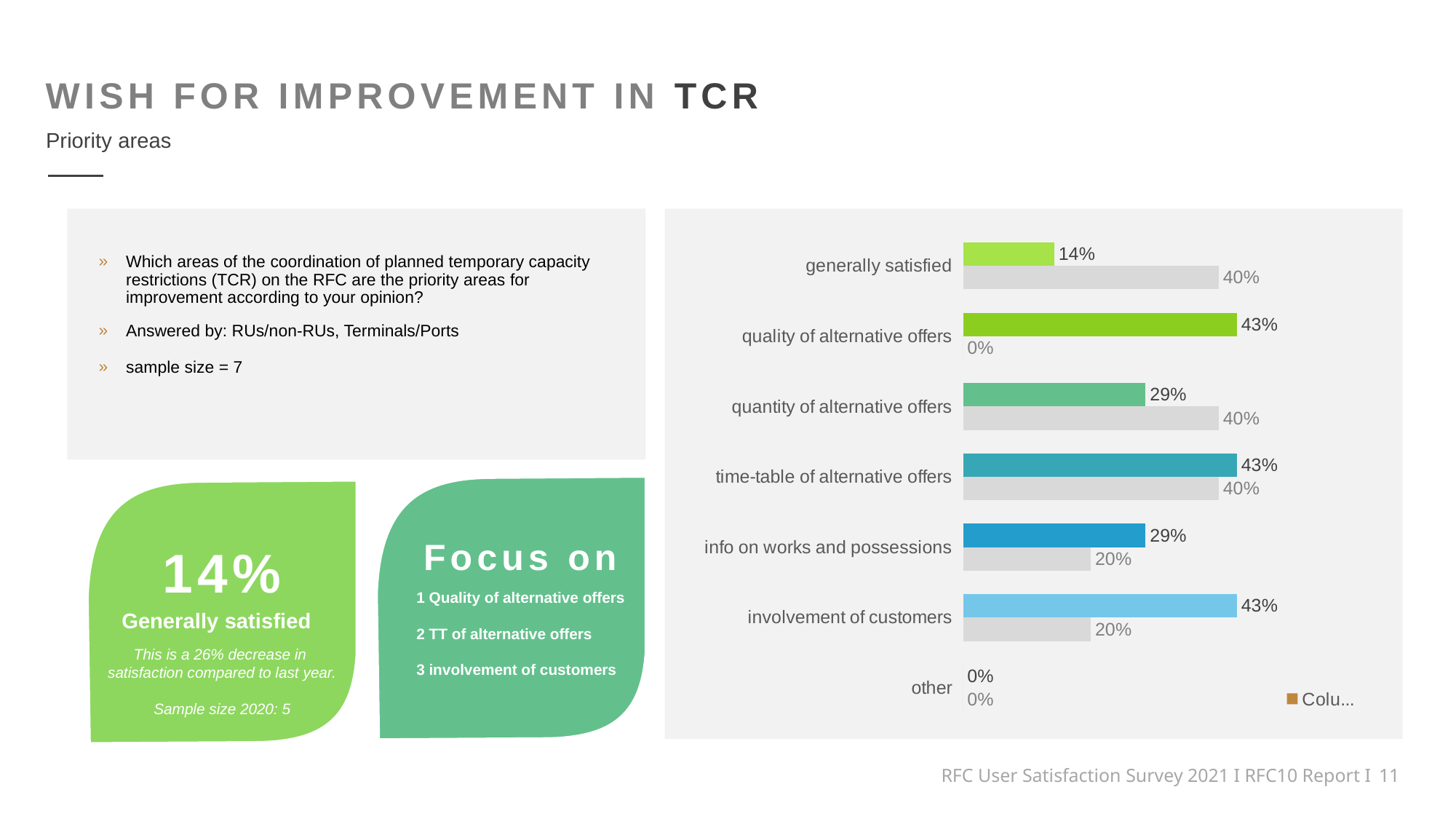
What is the value of the grey (lower) bar for 'info on works and possessions'? 20% What kind of chart is shown on the slide? bar chart How many categories are listed on the chart's vertical axis? 7 What is the value of the grey (lower) bar for 'generally satisfied'? 40% What is the difference between the coloured bar and the grey bar for 'quality of alternative offers'? 43% How many bars are shown for each category on the chart? 2 What is the value of the coloured (upper) bar for 'generally satisfied'? 14% What is the value of the coloured (upper) bar for 'quantity of alternative offers'? 29% What is the difference between the grey bar and the coloured bar for 'generally satisfied'? 26% Which is larger for 'involvement of customers': the coloured (upper) bar or the grey (lower) bar? the coloured (upper) bar What is the value of the coloured (upper) bar for 'quality of alternative offers'? 43% Which category has the lowest value for the coloured (upper) bar? other